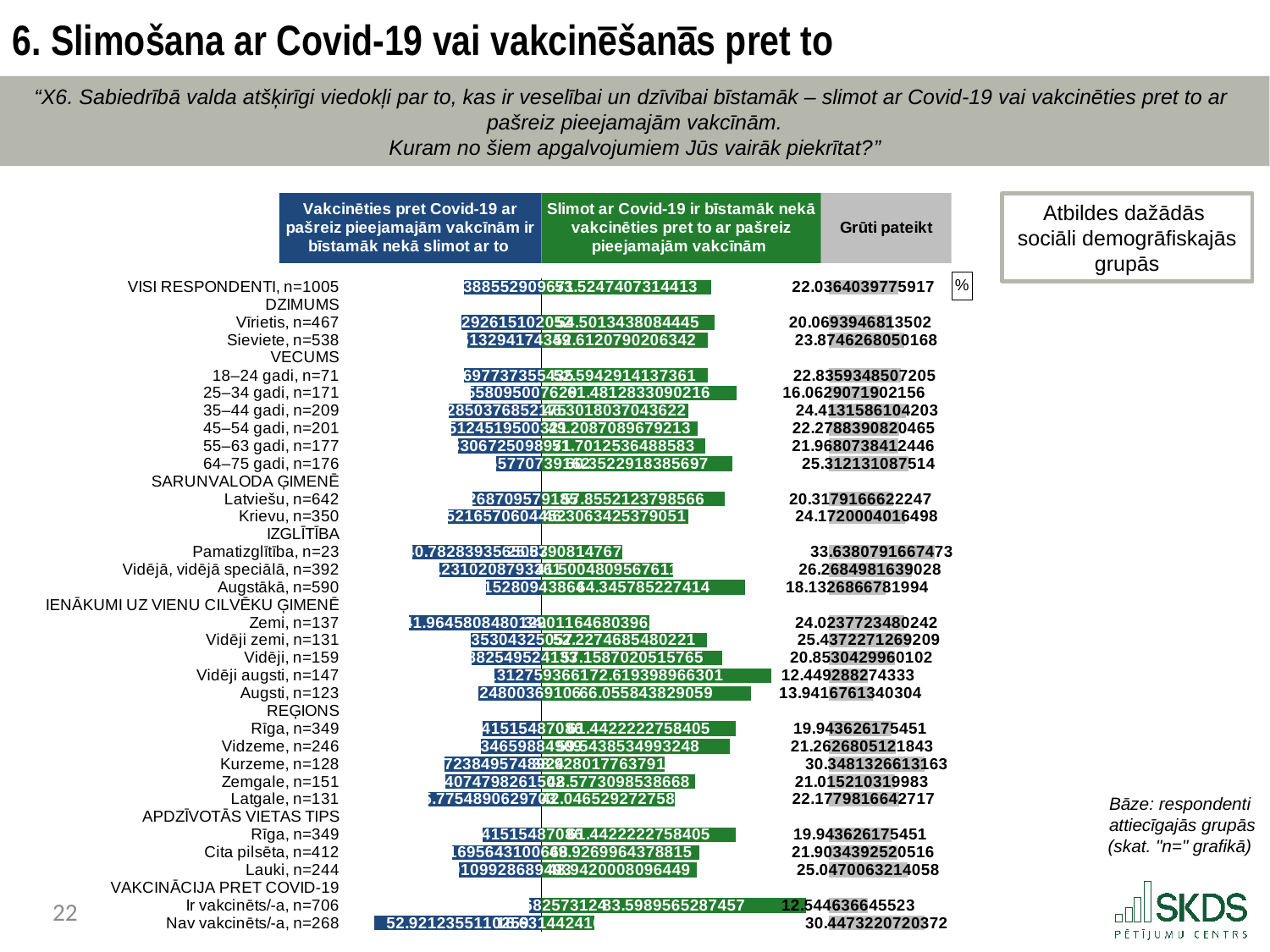
How many series does the chart's legend list? 3 What kind of chart is shown on the slide? Bar chart For the group "Ir vakcinēts/-a, n=706", which is larger: the blue series (vaccination is more dangerous) or the green series (getting sick is more dangerous)? Green series (getting sick is more dangerous) What is the label of the third (grey) series in the legend? Grūti pateikt Which colour represents the series "Vakcinēties pret Covid-19 ar pašreiz pieejamajām vakcīnām ir bīstamāk nekā slimot ar to"? Blue For the group "Nav vakcinēts/-a, n=268", which is larger: the blue series (vaccination is more dangerous) or the green series (getting sick is more dangerous)? Blue series (vaccination is more dangerous) How many respondents (n) are in the "VISI RESPONDENTI" group? 1005 Among all groups, which has the largest share for the blue series (vaccination is more dangerous than getting sick)? Nav vakcinēts/-a, n=268 Among all groups, which has the largest "Grūti pateikt" share? Pamatizglītība, n=23 How many respondents (n) are in the "Pamatizglītība" group? 23